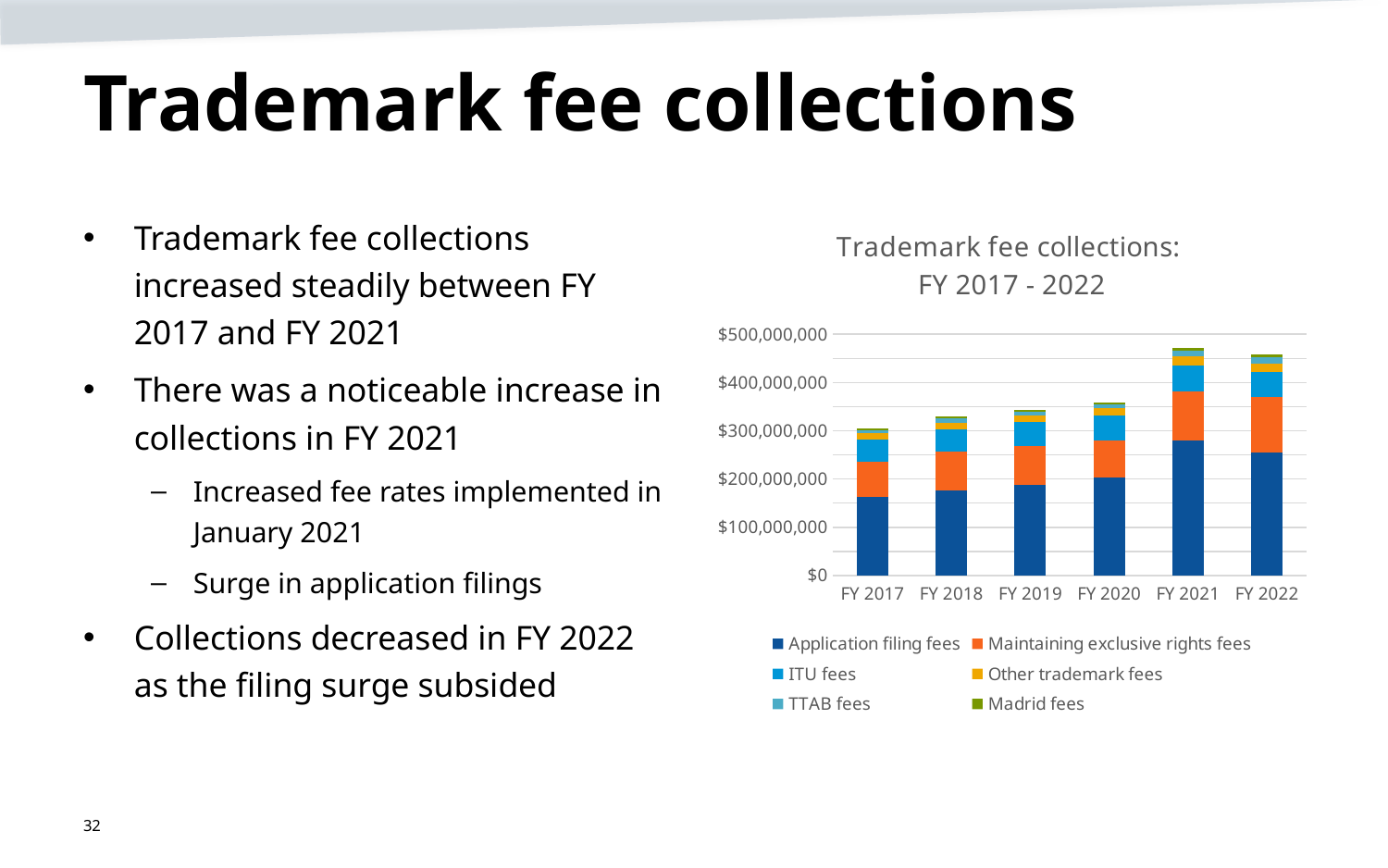
Is the total fee collection for FY 2021 greater or less than $400,000,000? greater Which fiscal year has the highest total trademark fee collections? FY 2021 Is the total fee collection for FY 2020 greater or less than $400,000,000? less Is the Application filing fees value for FY 2017 greater or less than $200,000,000? less Do total trademark fee collections rise or fall from FY 2017 to FY 2021? rise What kind of chart is shown on the slide? Stacked bar chart How many fiscal years are shown on the x axis of the chart? 6 Which series is shown in dark blue at the bottom of each stacked bar? Application filing fees What is the title of the chart? Trademark fee collections: FY 2017 - 2022 Which fiscal year has the lowest total trademark fee collections? FY 2017 Which has the larger total fee collection, FY 2020 or FY 2017? FY 2020 How many series does the chart's legend list? 6